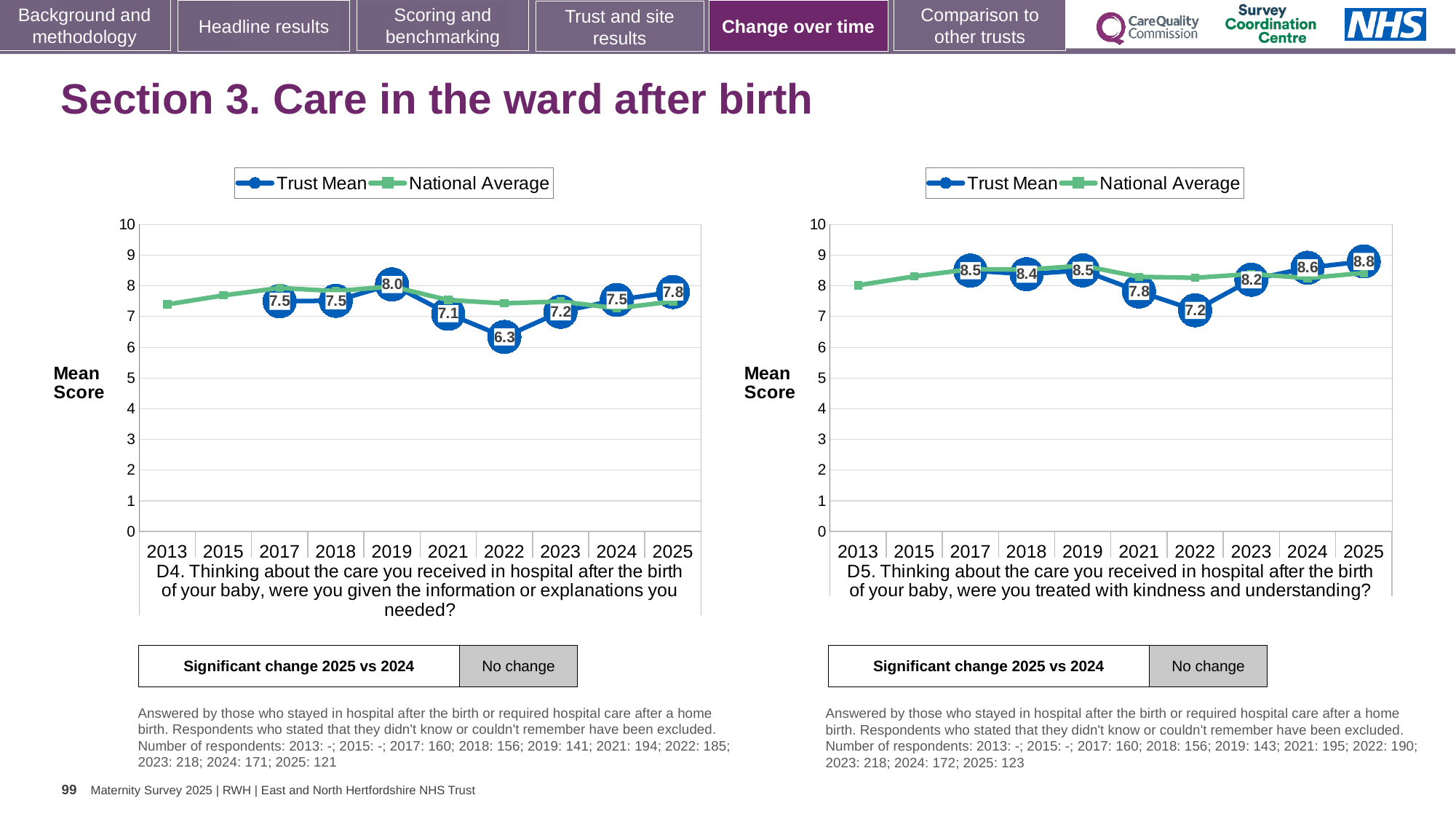
On the right chart (D5), what is the Trust Mean for 2021? 7.8 How many series does the legend of the left chart (D4) list? 2 On the right chart (D5), which year has the lowest Trust Mean? 2022 On the left chart (D4), which year has the highest Trust Mean? 2019 On the left chart (D4), what is the difference between the Trust Mean in 2019 and in 2022? 1.7 What kind of chart is the right chart (D5)? Line chart On the right chart (D5), is the Trust Mean for 2024 or 2023 larger? 2024 On the right chart (D5), which year has the highest Trust Mean? 2025 On the right chart (D5), what is the difference between the Trust Mean in 2025 and in 2022? 1.6 On the left chart (D4), what is the Trust Mean for 2025? 7.8 On the left chart (D4), what is the Trust Mean for 2022? 6.3 On the left chart (D4), which year has the lowest Trust Mean? 2022